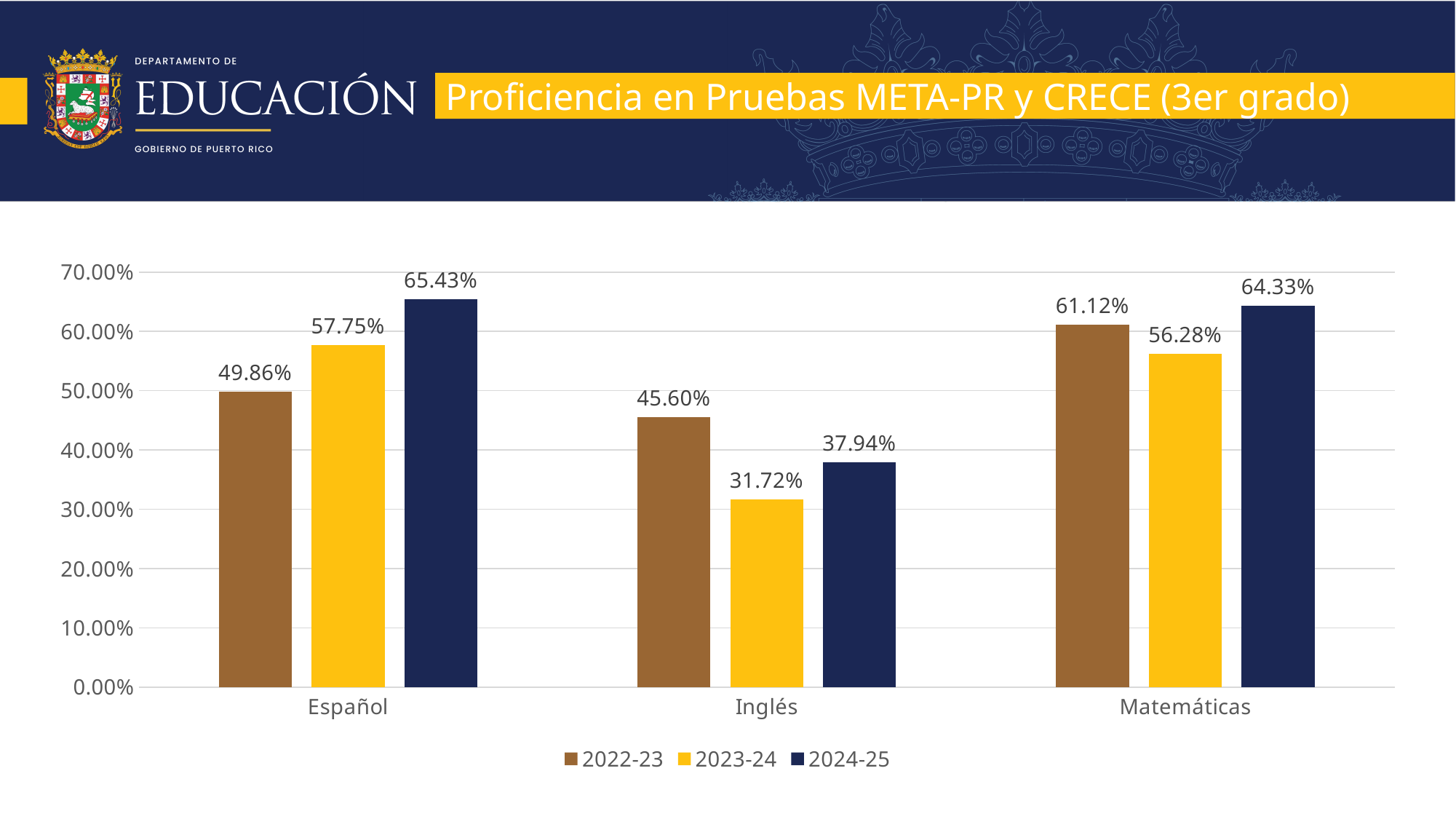
What is the difference between the 2024-25 and 2022-23 values for Español? 15.57% What is the value for Español in the 2024-25 series? 65.43% How many subject categories are shown on the x axis? 3 Is the value for Inglés in 2024-25 greater or less than 40.00%? less Which subject has the highest value in the 2024-25 series? Español Which is larger for Matemáticas: the 2022-23 value or the 2023-24 value? 2022-23 What is the value for Inglés in the 2023-24 series? 31.72% How many series does the legend list? 3 What is the title of the slide's chart? Proficiencia en Pruebas META-PR y CRECE (3er grado) What is the value for Matemáticas in the 2022-23 series? 61.12% What kind of chart is shown on the slide? Bar chart Which subject has the lowest value in the 2023-24 series? Inglés